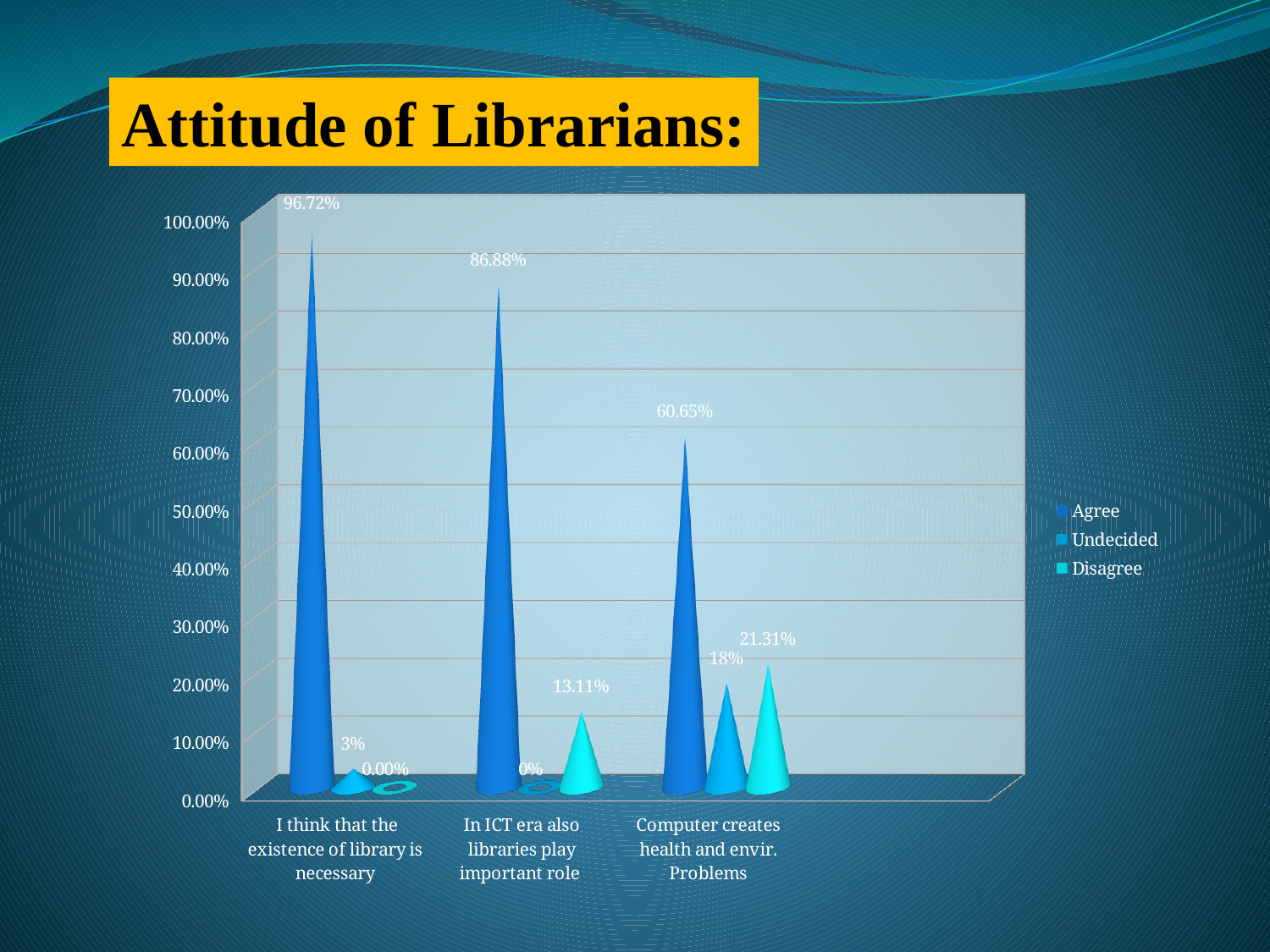
What is the Agree value for "In ICT era also libraries play important role"? 86.88% How many categories are shown on the x axis? 3 Which category has the lowest Agree value? Computer creates health and envir. Problems What is the Disagree value for "In ICT era also libraries play important role"? 13.11% What is the title of the slide containing the chart? Attitude of Librarians: Which category has the highest Agree value? I think that the existence of library is necessary What is the Agree value for "I think that the existence of library is necessary"? 96.72% What is the Disagree value for "Computer creates health and envir. Problems"? 21.31% What is the Undecided value for "Computer creates health and envir. Problems"? 18% How many series does the legend list? 3 For "Computer creates health and envir. Problems", which is larger: Undecided or Disagree? Disagree What is the difference between the Agree values for "I think that the existence of library is necessary" and "In ICT era also libraries play important role"? 9.84%